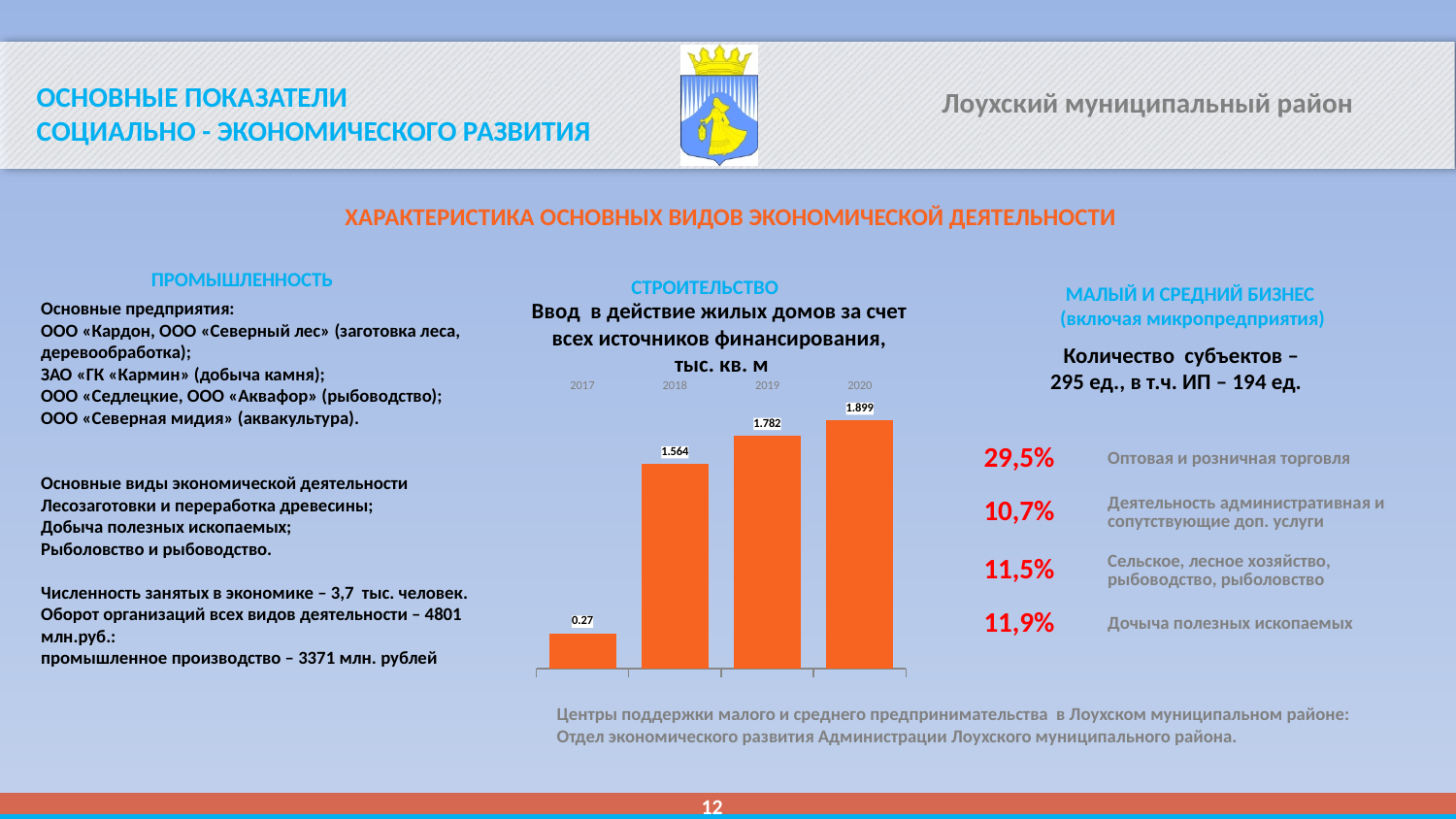
What is the difference between the values for 2020 and 2019? 0.117 What kind of chart is shown on the slide? Bar chart How many years are shown in the chart? 4 Do the values rise or fall from 2017 to 2020? Rise Which year has the lowest value in the chart? 2017 What is the value for 2017 in the chart? 0.27 What is the value for 2019 in the chart? 1.782 Which year has the highest value in the chart? 2020 Which is larger, the value for 2018 or the value for 2019? 2019 What is the difference between the values for 2018 and 2017? 1.294 What is the value for 2018 in the chart? 1.564 What is the value for 2020 in the chart? 1.899